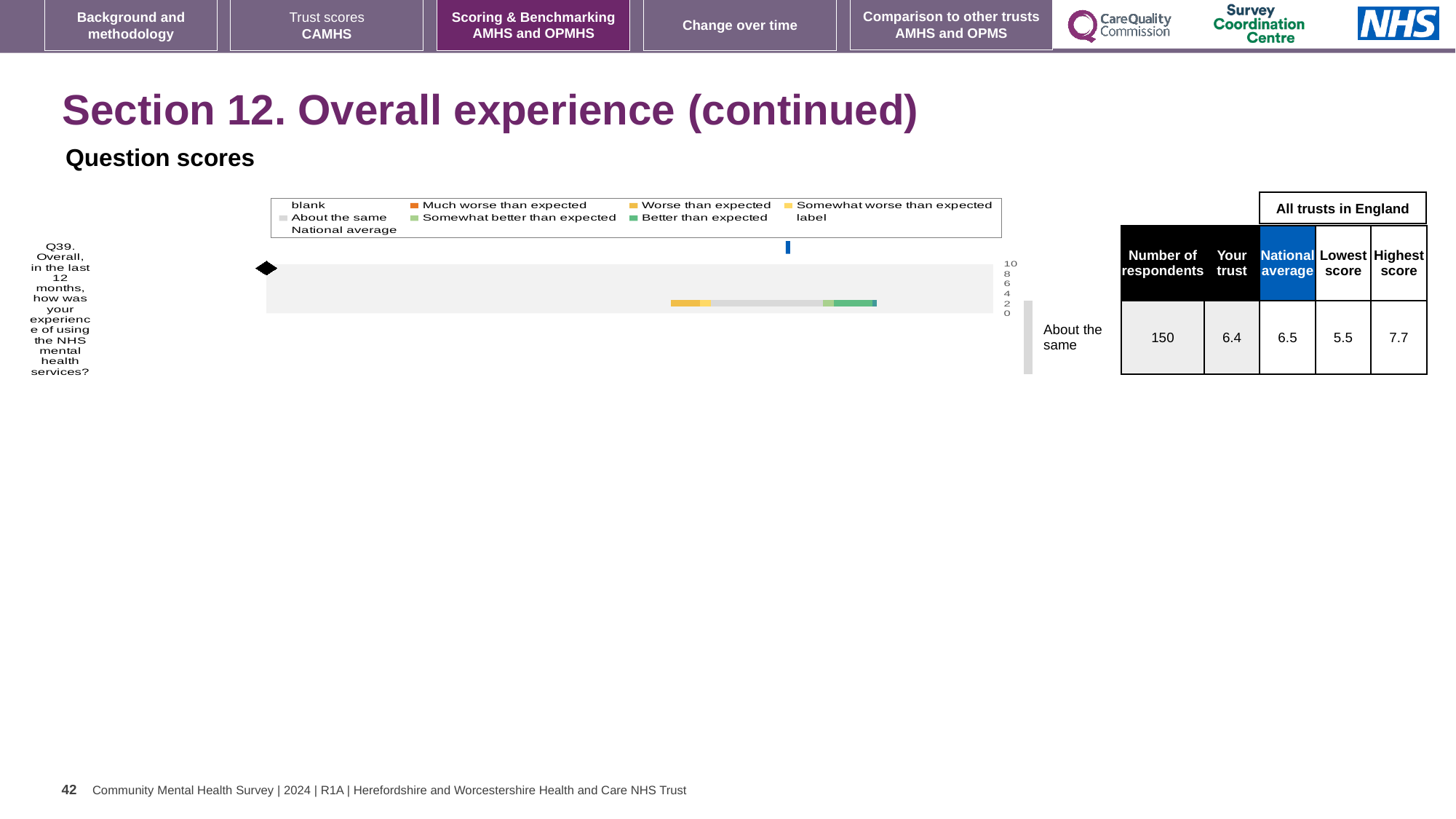
What is the 'Your trust' score for Q39 (Overall, in the last 12 months, how was your experience of using the NHS mental health services?)? 6.4 What is the highest score among all trusts in England for Q39? 7.7 What is the difference between the national average and the trust's score for Q39? 0.1 What kind of chart is used to show the question scores? Bar chart What benchmark category is the trust's Q39 score placed in? About the same What is the difference between the highest score and the lowest score for Q39? 2.2 What is the lowest score among all trusts in England for Q39? 5.5 What is the national average score shown for Q39? 6.5 Which legend entry represents the best benchmark category on the chart? Better than expected Which is larger for Q39: the trust's score or the national average? National average How many survey questions are plotted on the chart? 1 How many respondents answered Q39? 150